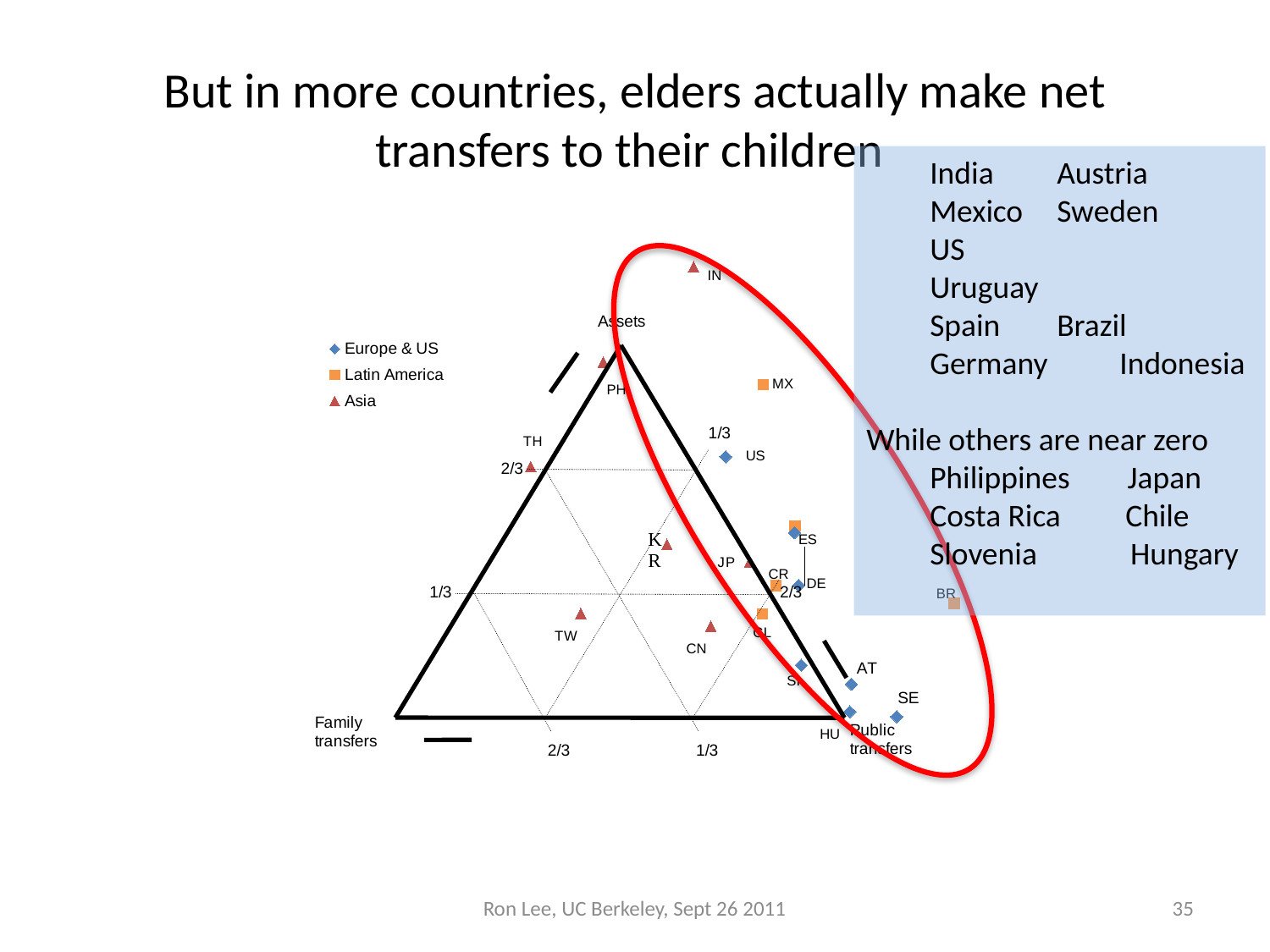
What are the three series named in the chart legend? Europe & US, Latin America, Asia Which series does the point labelled BR belong to? Latin America What are the three corners of the triangle in the chart labelled? Assets, Family transfers, Public transfers Which labelled point is plotted highest on the chart, above the Assets corner? IN Which of the two points, IN or HU, is plotted closer to the Public transfers corner? HU Which series does the point labelled MX belong to? Latin America What is the title of the slide containing the chart? But in more countries, elders actually make net transfers to their children What kind of chart is shown on the slide? Ternary (triangular) scatter plot Which series does the point labelled TH belong to? Asia Which of the two points, TH or SE, is plotted closer to the Family transfers corner? TH Which series does the point labelled US belong to? Europe & US How many series does the chart legend list? 3